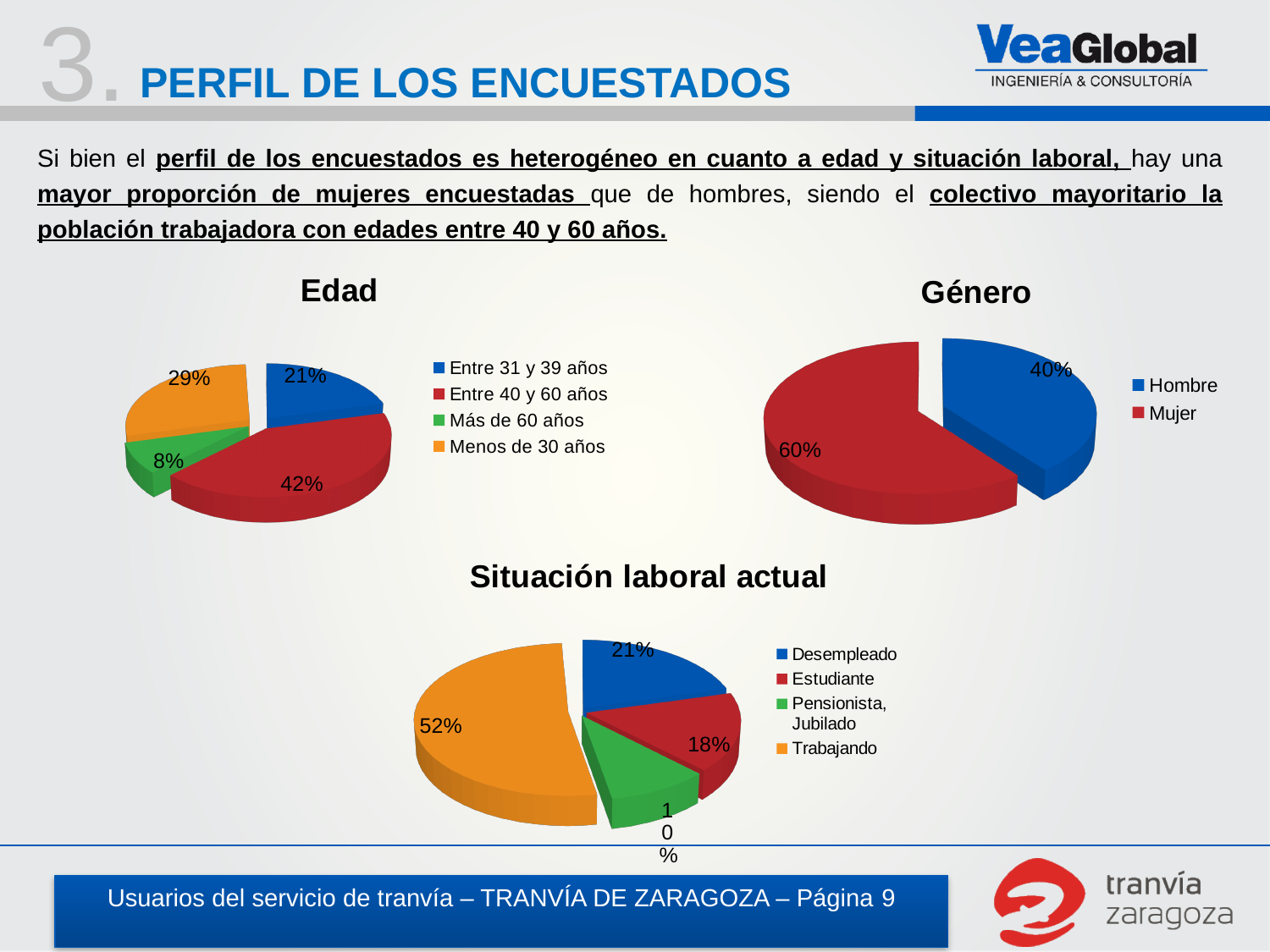
In the "Situación laboral actual" chart, what share is "Trabajando"? 52% In the "Situación laboral actual" chart, which category has the smallest share? Pensionista, Jubilado In the "Edad" chart, what share is "Entre 40 y 60 años"? 42% What kind of chart is the "Género" chart? Pie chart In the "Edad" chart, which category has the largest share? Entre 40 y 60 años In the "Género" chart, what share is "Mujer"? 60% In the "Situación laboral actual" chart, what is the difference between "Desempleado" and "Estudiante"? 3% In the "Edad" chart, what is the difference between "Menos de 30 años" and "Entre 31 y 39 años"? 8% In the "Situación laboral actual" chart, what share is "Estudiante"? 18% In the "Edad" chart, which category has the smallest share? Más de 60 años In the "Género" chart, which is larger, "Hombre" or "Mujer"? Mujer How many categories does the "Edad" chart show? 4